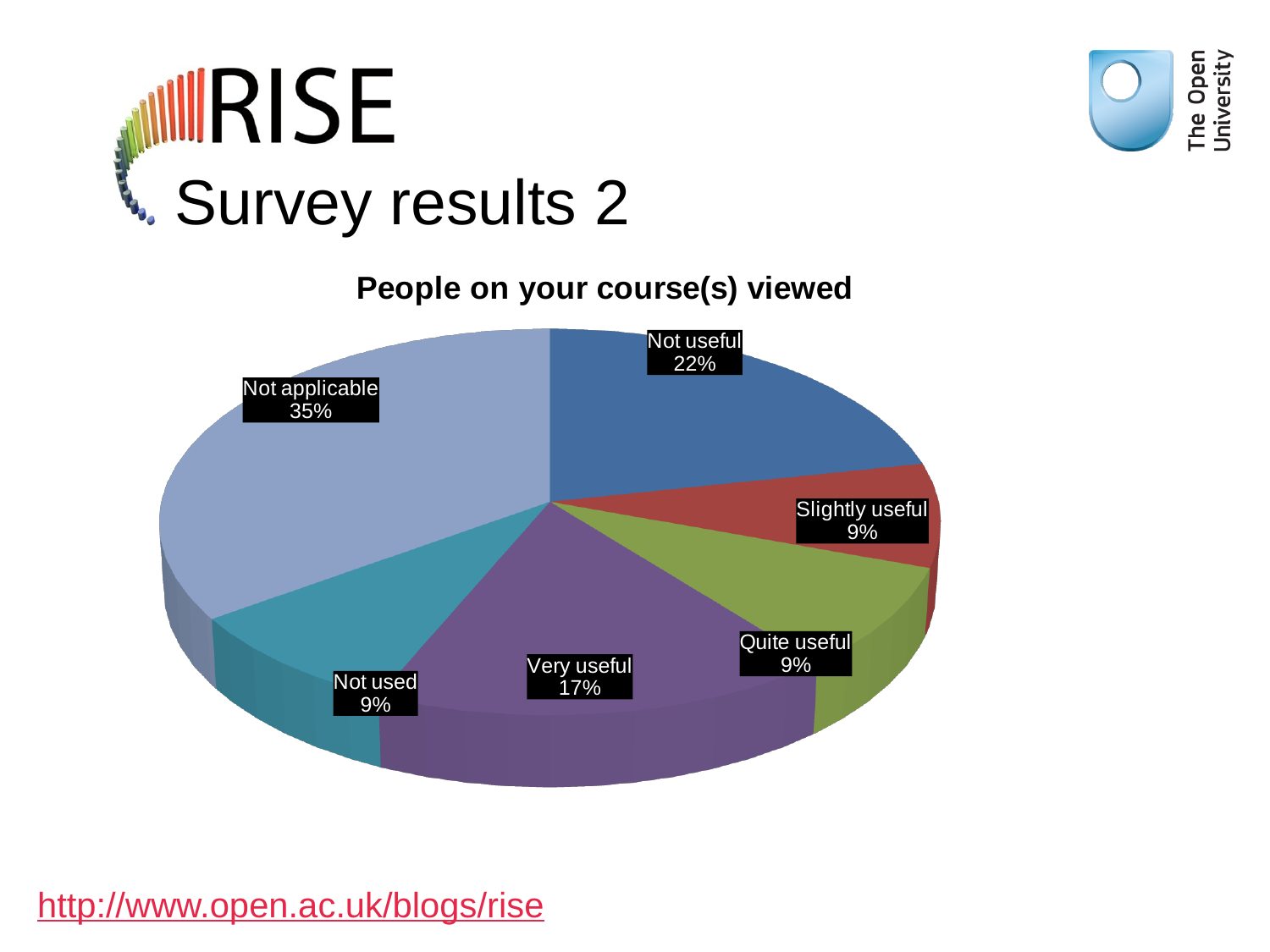
What is the combined percentage of the "Very useful" and "Quite useful" slices? 26% What percentage of the pie is labelled "Slightly useful"? 9% What type of chart is shown on the slide? Pie chart How many slices are labelled 9%? 3 What percentage of the pie is labelled "Very useful"? 17% What is the difference in percentage points between the "Not applicable" slice and the "Not useful" slice? 13 What percentage of the pie is labelled "Not useful"? 22% Which slice of the pie is the largest? Not applicable What percentage of the pie is labelled "Not applicable"? 35% Which is larger, the "Very useful" slice or the "Quite useful" slice? Very useful What is the title of the chart? People on your course(s) viewed How many slices does the pie chart have? 6